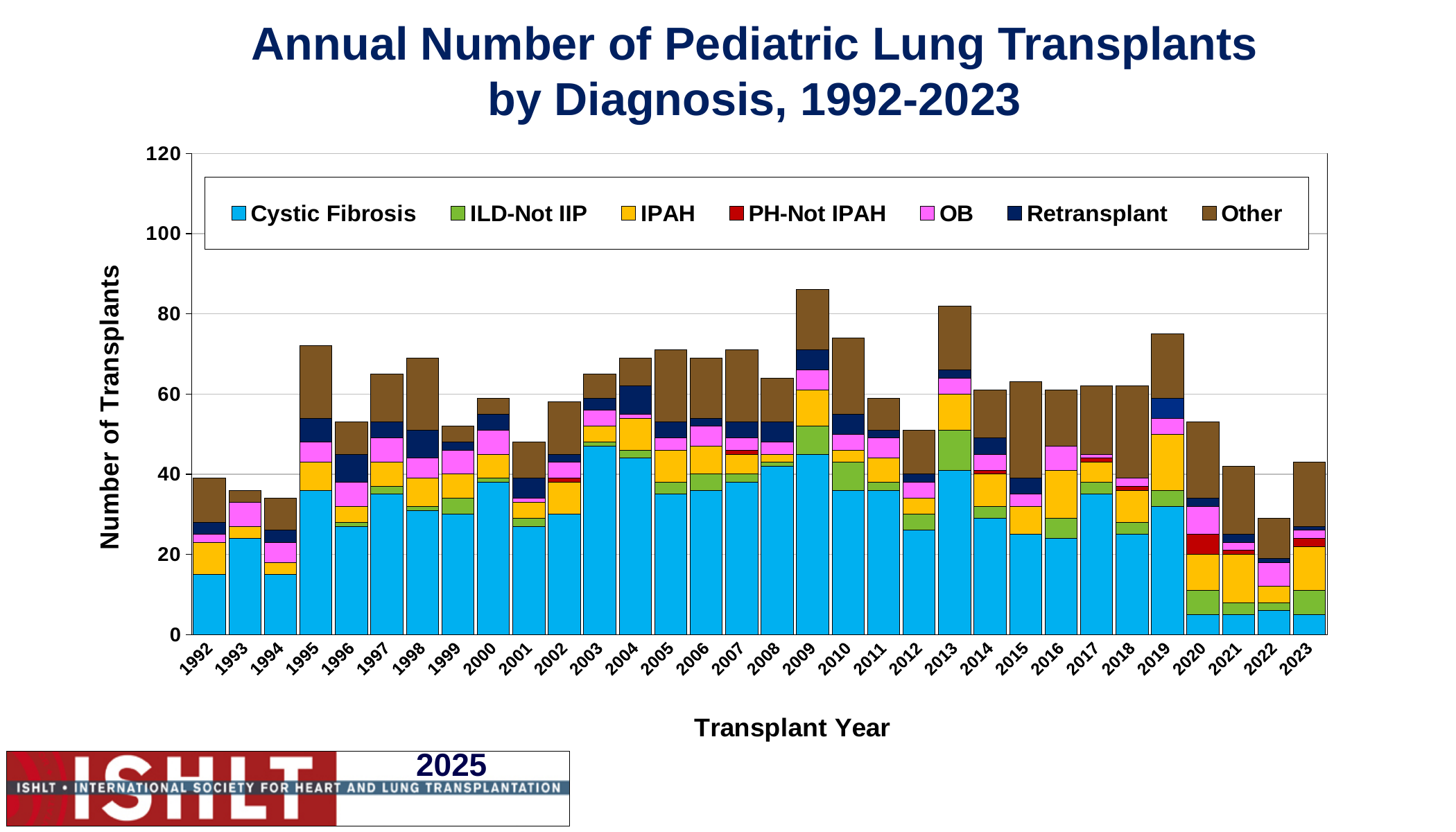
Which year has a larger total number of transplants, 1995 or 1996? 1995 Is the Cystic Fibrosis value for 2003 greater or less than 40? greater What kind of chart is shown on the slide? Stacked bar chart Is the total number of transplants in 2019 greater or less than 70? greater Is the total number of transplants in 2009 greater or less than 80? greater Do the total numbers of transplants rise or fall from 2019 to 2022? fall Which transplant year has the highest total number of transplants? 2009 Which transplant year has the lowest total number of transplants? 2022 How many series does the legend list? 7 How many transplant years are shown on the x axis? 32 What is the label of the y axis? Number of Transplants